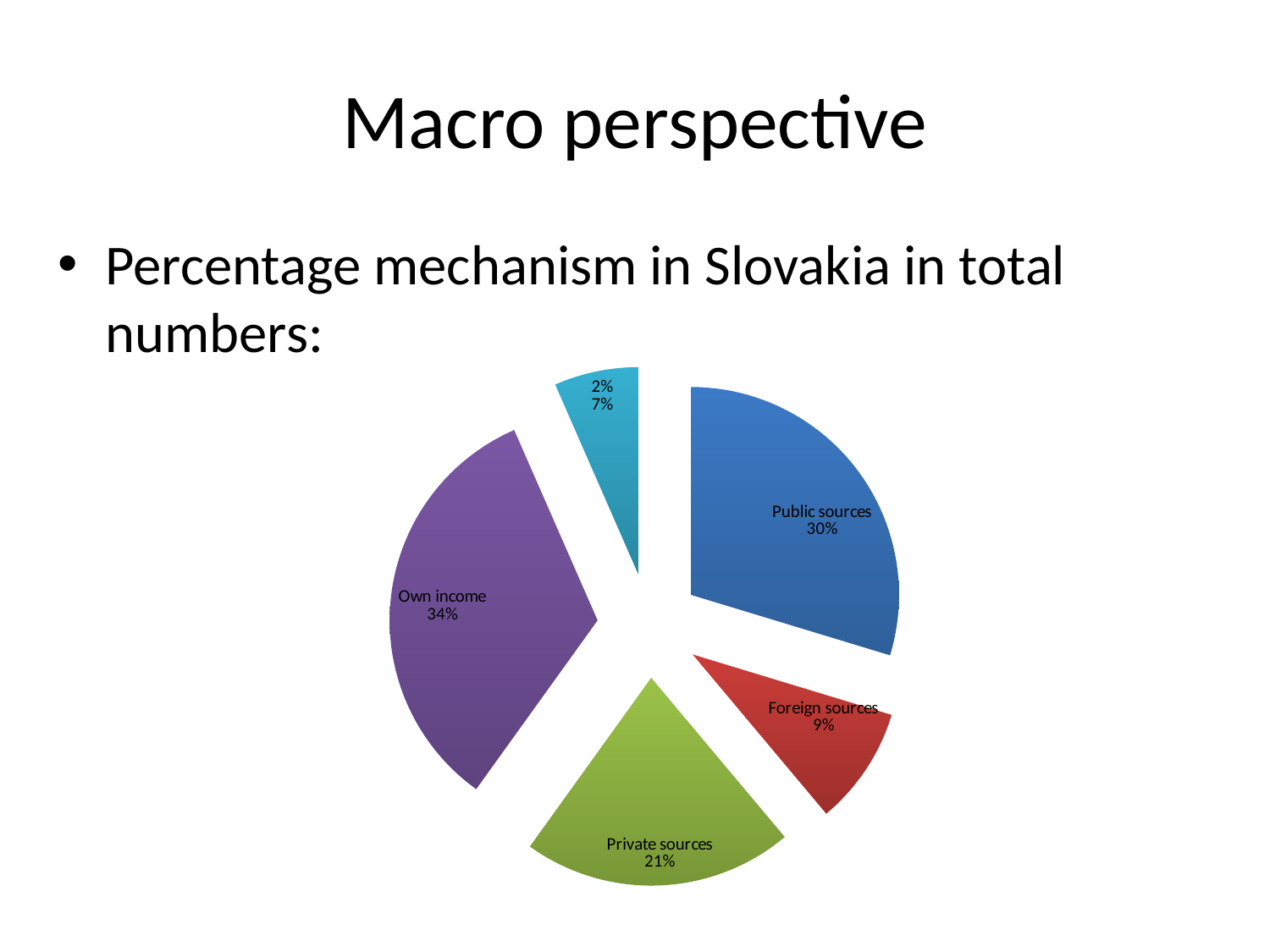
What percentage is shown for Private sources? 21% Which is larger, Foreign sources or Private sources? Private sources What is the difference in percentage points between Own income and Public sources? 4 percentage points Which named category has the largest slice of the pie? Own income What share of the pie does Public sources account for? 30% What is the difference in percentage points between Private sources and Foreign sources? 12 percentage points Which is larger, Public sources or Private sources? Public sources What kind of chart is shown on the slide? Pie chart What colour is the Public sources slice? Blue What percentage is shown for Own income? 34% What colour is the Own income slice? Purple What percentage is shown for Foreign sources? 9%